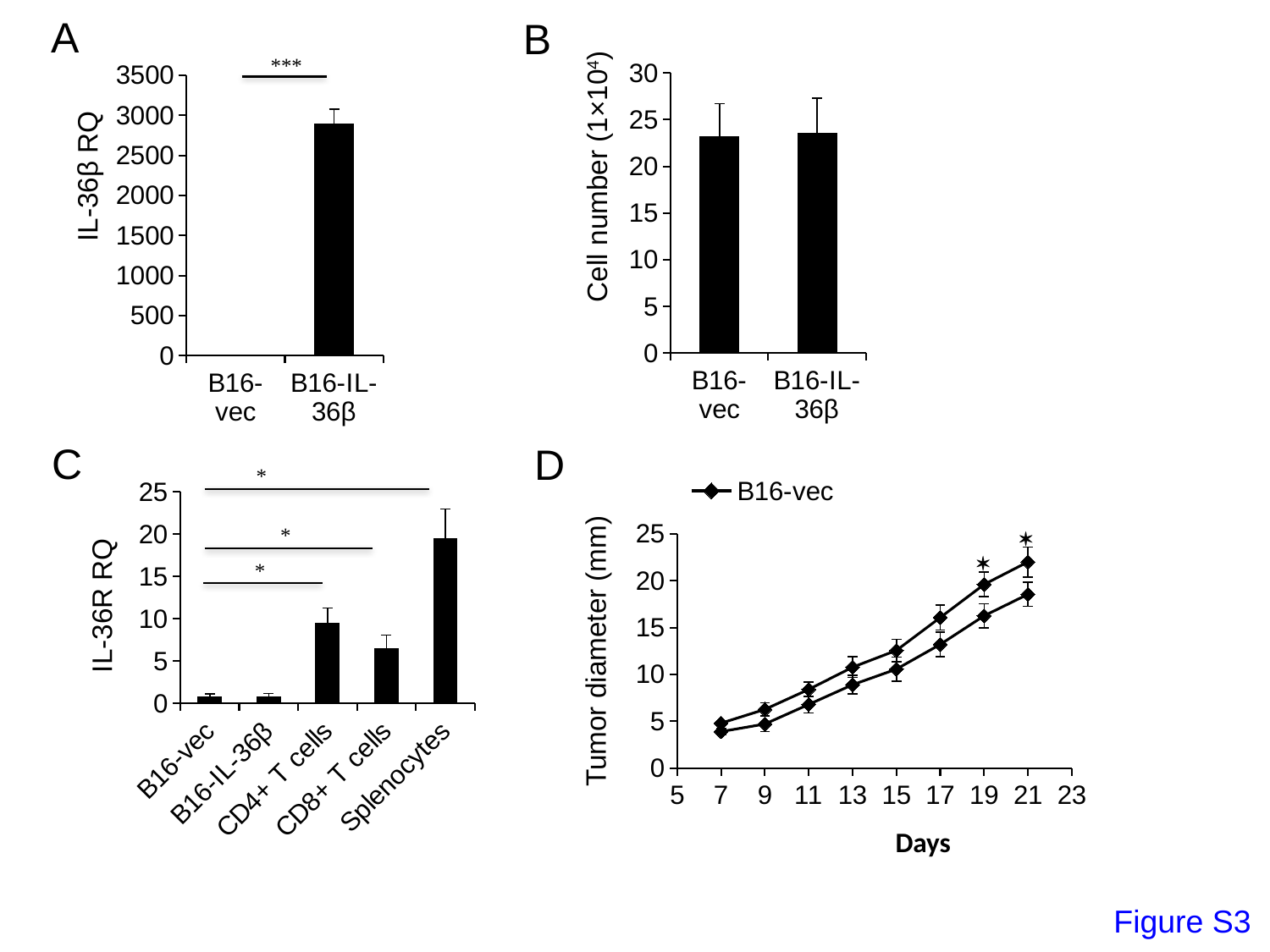
In chart B (Cell number), is the value for B16-vec greater or less than 20? greater In chart A (IL-36β RQ), which category has the higher value? B16-IL-36β In chart D (Tumor diameter), do the values rise or fall as the days increase? rise In chart C (IL-36R RQ), how many categories are shown on the x axis? 5 In chart C (IL-36R RQ), which category has the highest value? Splenocytes In chart C (IL-36R RQ), is the value for Splenocytes greater or less than 15? greater What kind of chart is chart A (IL-36β RQ)? bar chart What kind of chart is chart D (Tumor diameter)? line chart In chart D (Tumor diameter), what is the label on the x axis? Days In chart B (Cell number), how many categories are shown on the x axis? 2 In chart A (IL-36β RQ), is the value for B16-IL-36β greater or less than 2500? greater In chart C (IL-36R RQ), which is larger, CD4+ T cells or CD8+ T cells? CD4+ T cells